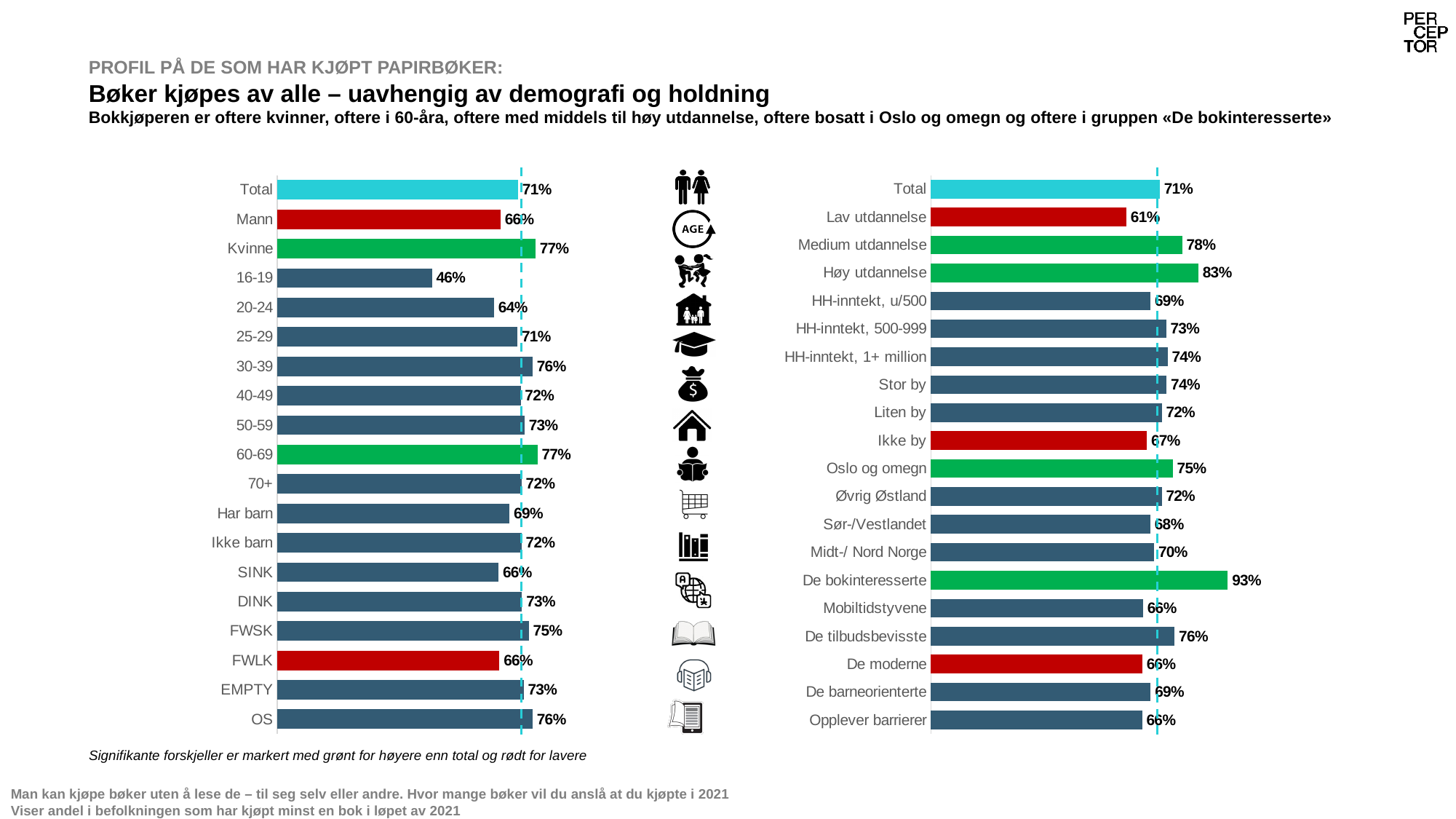
In the right chart, what is the value for Høy utdannelse? 83% In the left chart, what is the value for Kvinne? 77% In the right chart, which category has the lowest value? Lav utdannelse In the right chart, what is the difference between De bokinteresserte and Total? 22% What type of chart is the right chart? Bar chart How many bars are shown in the left chart? 19 In the left chart, which category has the lowest value? 16-19 In the right chart, what is the value for Ikke by? 67% In the left chart, what is the difference between the values for Kvinne and Mann? 11% In the right chart, which category has the highest value? De bokinteresserte In the left chart, what is the value for the 16-19 age group? 46% In the right chart, which is larger: Stor by or Liten by? Stor by